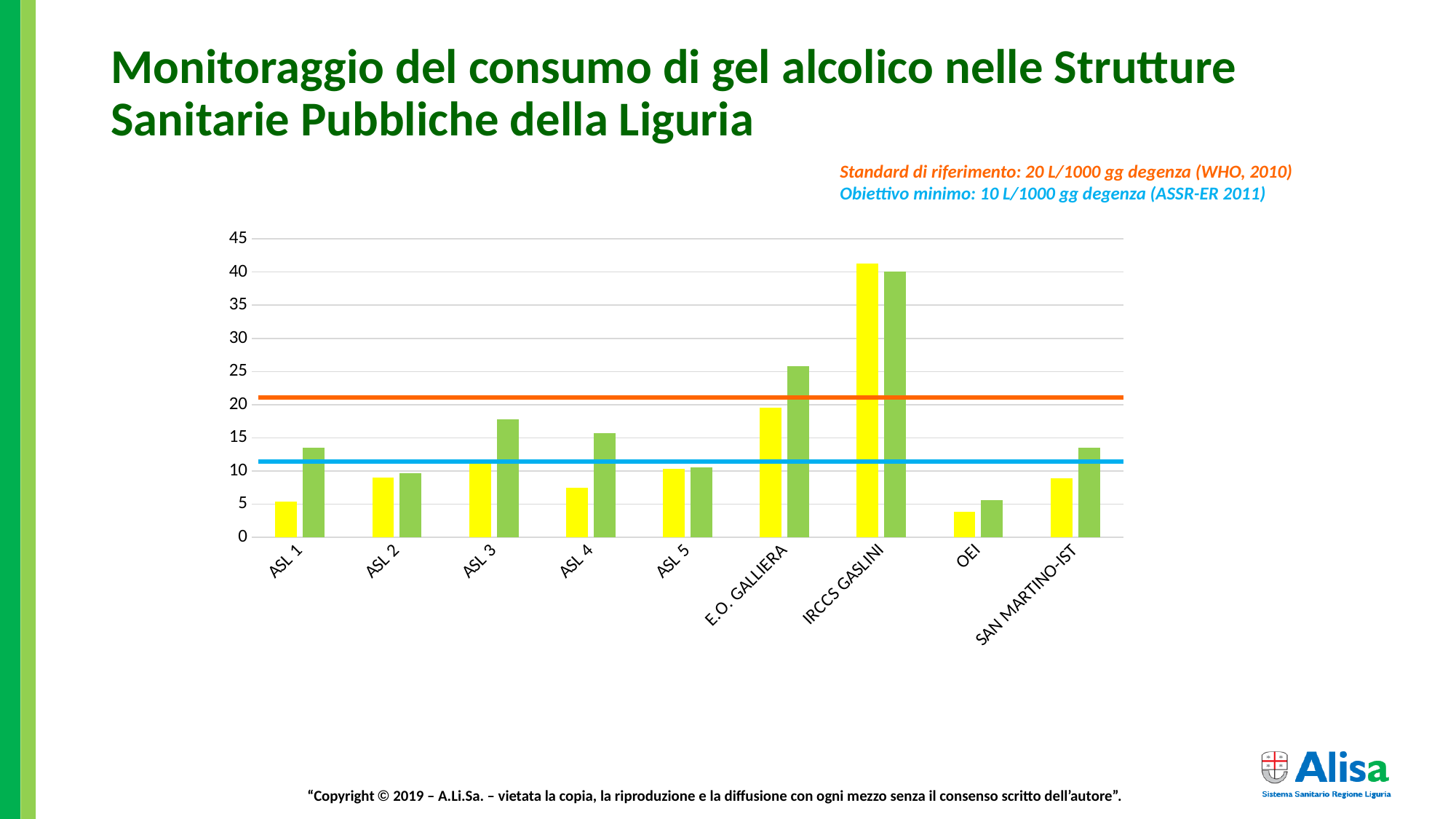
Which is larger: the green bar for ASL 3 or the green bar for ASL 4? ASL 3 Which structure has the highest bars in the chart? IRCCS GASLINI Is the green bar for ASL 1 greater or less than 10? greater Is the green bar for ASL 3 greater or less than 20? less Is the green bar for E.O. GALLIERA greater or less than 20? greater How many structures (categories) are shown on the x axis of the chart? 9 What reference standard (Standard di riferimento) is stated above the chart? 20 L/1000 gg degenza (WHO, 2010) Which structure has the lowest bars in the chart? OEI What kind of chart is shown on the slide? bar chart